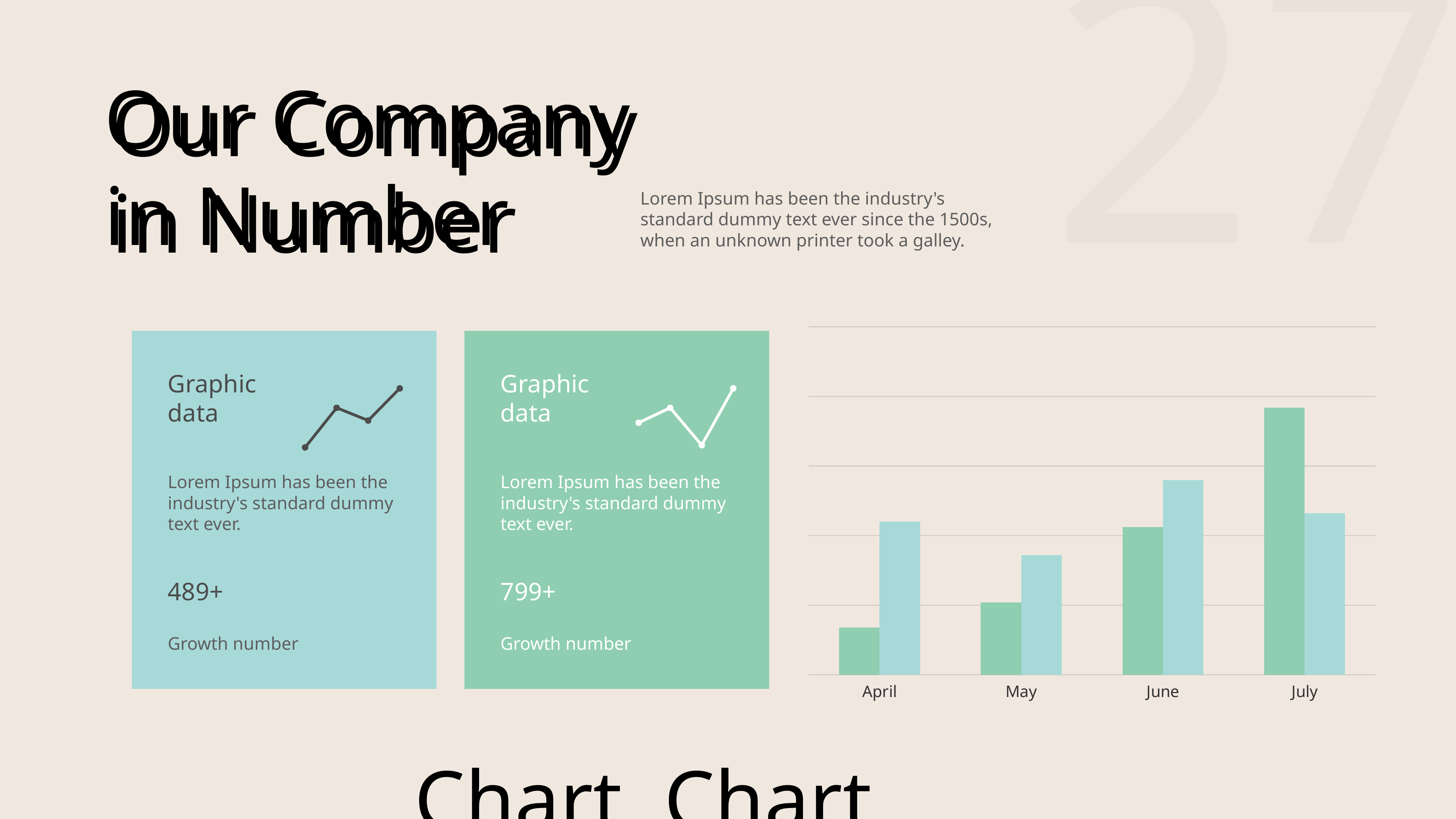
Do the green bars rise or fall from April to July? rise Which month has the tallest green bar in the bar chart? July Which month has the shortest green bar in the bar chart? April In July, which bar is taller, the green bar or the light blue bar? green Which month has the tallest light blue bar in the bar chart? June In April, which bar is taller, the green bar or the light blue bar? light blue What is the first month shown on the x axis of the bar chart? April How many bars are plotted for each month in the bar chart? 2 What kind of chart is shown on the right of the slide? bar chart Is the green bar for June taller or shorter than the green bar for May? taller How many months are shown on the x axis of the bar chart? 4 Which month has the shortest light blue bar in the bar chart? May